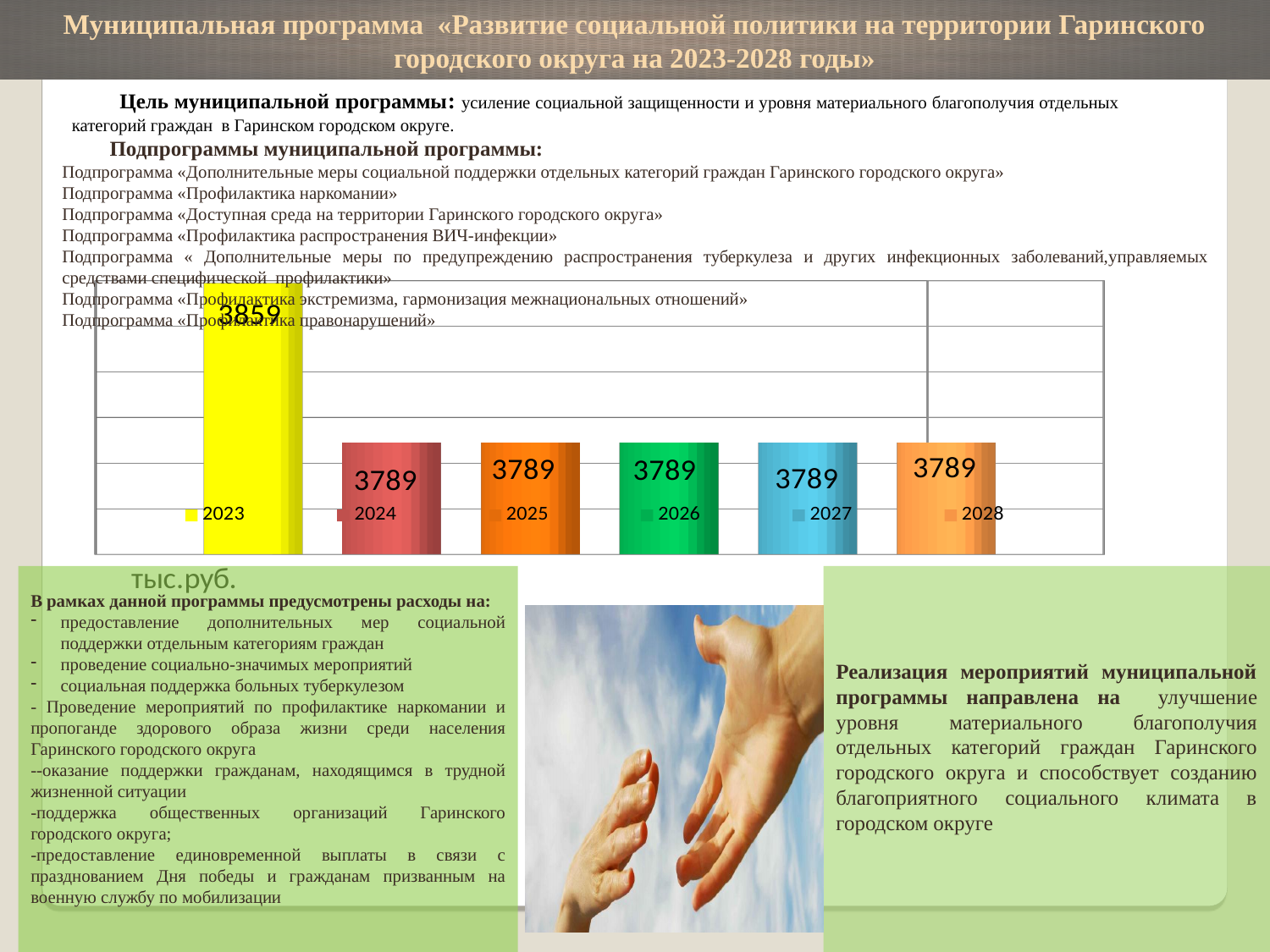
Does the value rise or fall from 2023 to 2024 in the bar chart? fall What kind of chart is shown on the slide? bar chart Are the values for 2024 and 2027 in the bar chart equal? yes What is the value shown for 2025 in the bar chart? 3789 What is the value shown for 2028 in the bar chart? 3789 How many years (bars) are shown in the bar chart? 6 What colour is the bar for 2023 in the chart? yellow What is the value shown for 2023 in the bar chart? 3859 What is the difference between the values for 2023 and 2024 in the bar chart? 70 What unit is indicated below the bar chart? тыс.руб. Which is larger in the bar chart, the value for 2023 or the value for 2026? 2023 Which year has the highest value in the bar chart? 2023